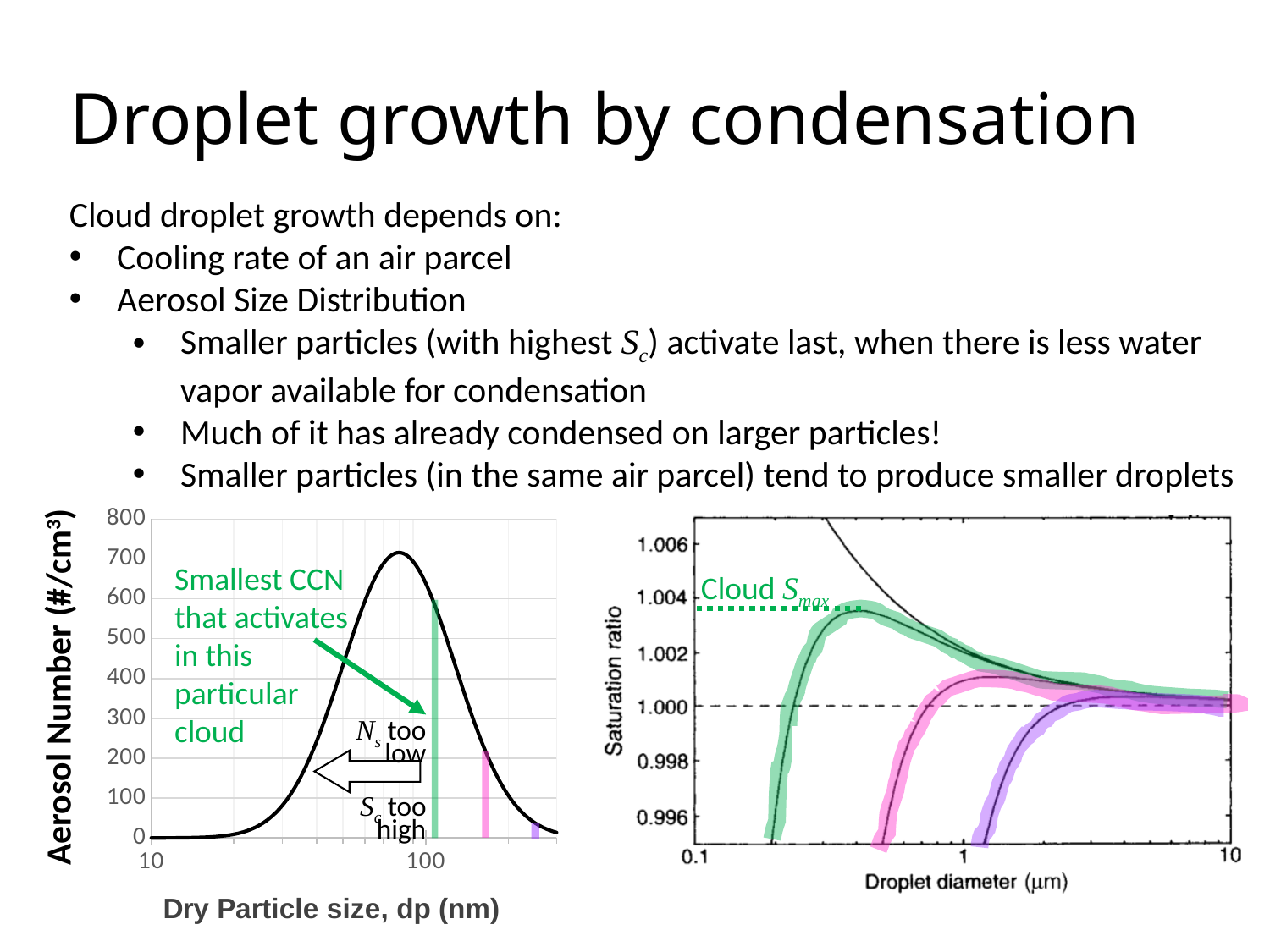
On the right chart, what is the label of the horizontal axis? Droplet diameter (μm) On the right chart, is the peak of the green curve greater or less than 1.002? greater What kind of chart is the left chart showing Aerosol Number versus Dry Particle size? line chart On the left chart, which coloured vertical bar is the shortest? purple On the left chart, is the height of the pink vertical bar greater or less than 300? less On the left chart, is the height of the green vertical bar greater or less than 400? greater On the right chart, which coloured curve reaches the highest saturation ratio? green On the left chart, which coloured vertical bar is the tallest? green On the left chart, what is the label of the vertical axis? Aerosol Number (#/cm³) On the left chart, how many coloured vertical bars are marked on the size distribution? 3